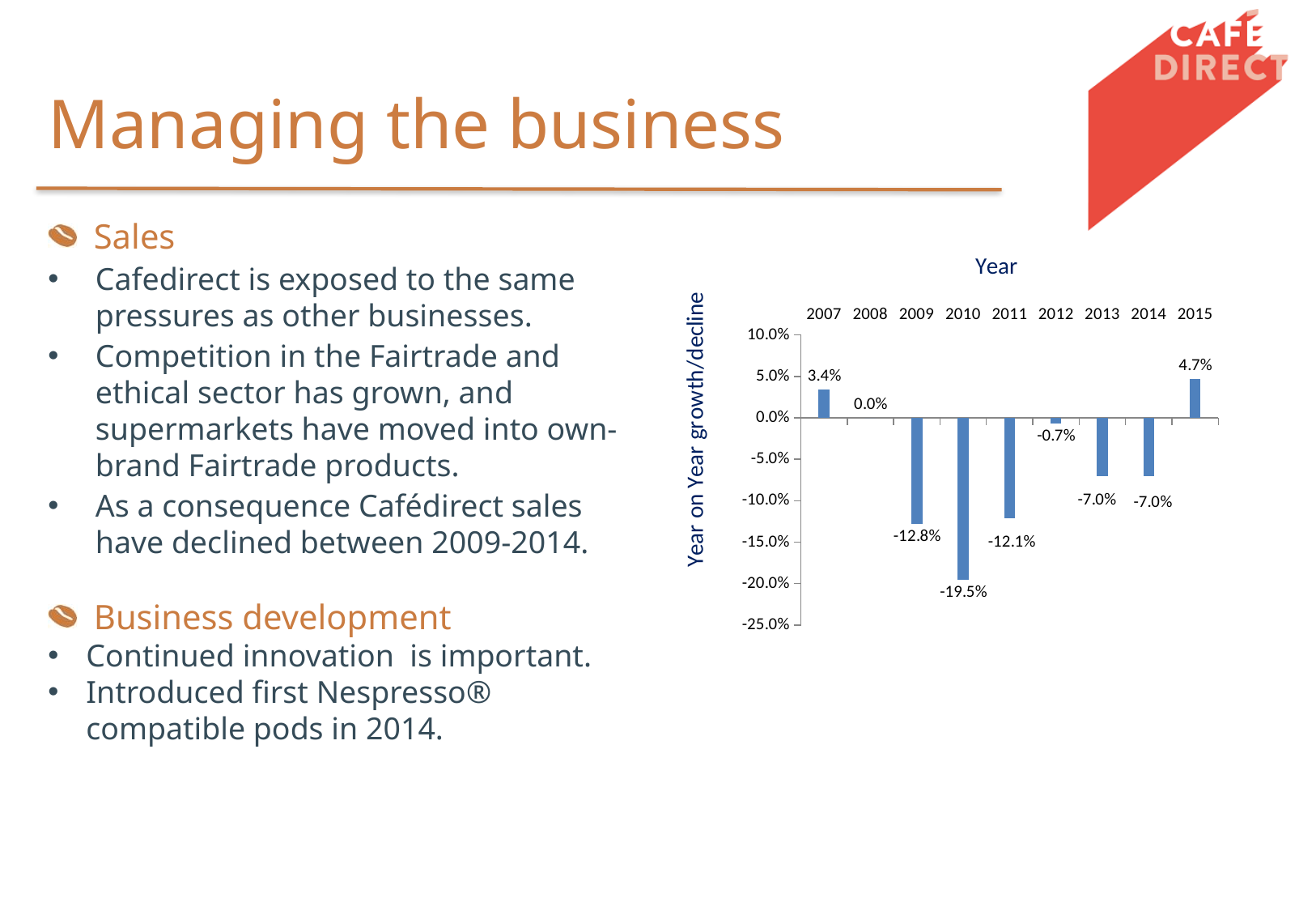
What is the year on year growth/decline value for 2012? -0.7% Which year has the larger value, 2009 or 2011? 2011 What is the label of the vertical axis of the chart? Year on Year growth/decline Is the value for 2010 greater or less than -15.0%? less What is the year on year growth/decline value for 2010? -19.5% Which year has the lowest year on year growth/decline value? 2010 How many years are plotted on the chart? 9 What kind of chart is shown on the slide? bar chart Which year has the highest year on year growth/decline value? 2015 What is the year on year growth/decline value for 2008? 0.0% What is the year on year growth/decline value for 2015? 4.7% What is the difference between the values for 2015 and 2007? 1.3%